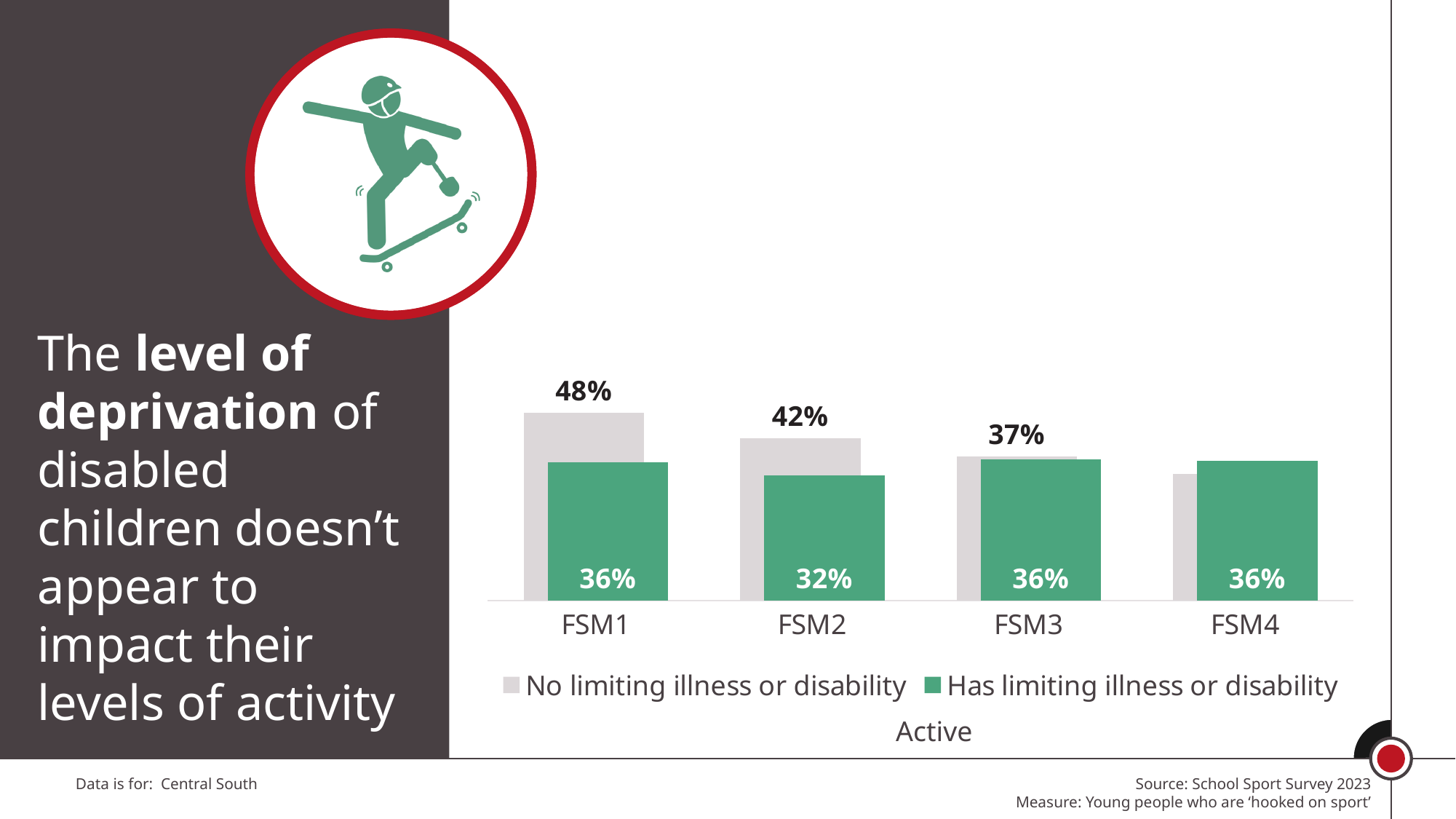
What is the value for 'Has limiting illness or disability' in FSM2? 32% In FSM2, which is larger: 'No limiting illness or disability' or 'Has limiting illness or disability'? No limiting illness or disability Do the 'No limiting illness or disability' values rise or fall from FSM1 to FSM4? Fall How many series does the legend list? 2 What is the value for 'No limiting illness or disability' in FSM3? 37% What is the value for 'Has limiting illness or disability' in FSM4? 36% What is the value for 'No limiting illness or disability' in FSM1? 48% What is the difference between the 'No limiting illness or disability' and 'Has limiting illness or disability' values in FSM1? 12 percentage points Which category has the lowest value for 'Has limiting illness or disability'? FSM2 Which category has the highest value for 'No limiting illness or disability'? FSM1 How many FSM categories are shown on the x axis? 4 What kind of chart is shown on the slide? Bar chart